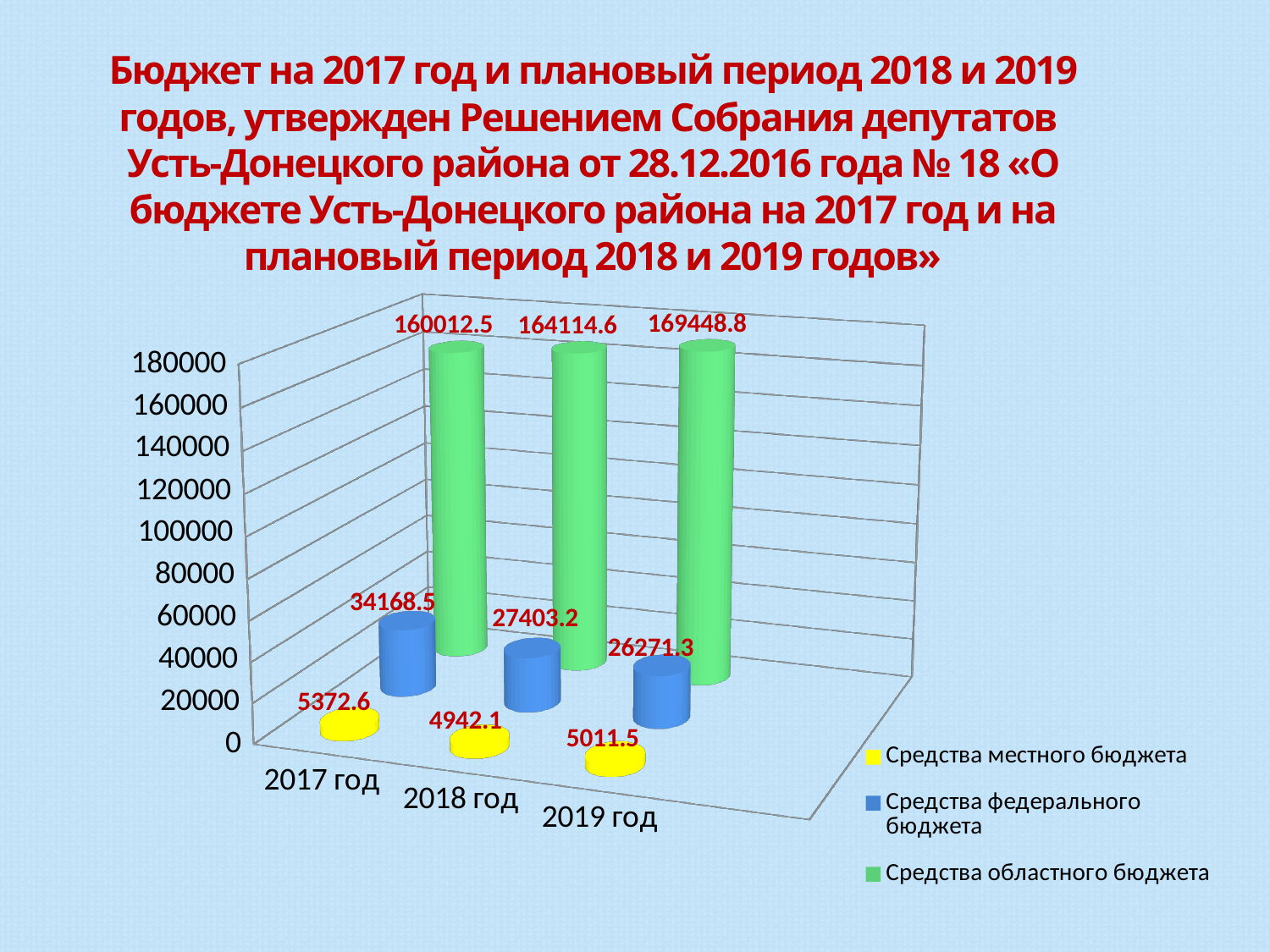
What is the difference between Средства федерального бюджета in 2017 год and in 2019 год? 7897.2 In which year is Средства областного бюджета highest? 2019 год Which is larger: Средства федерального бюджета in 2017 год or in 2018 год? 2017 год Do the values for Средства федерального бюджета rise or fall from 2017 год to 2019 год? Fall What is the value for Средства областного бюджета in 2017 год? 160012.5 How many years are shown on the x axis? 3 In which year is Средства местного бюджета lowest? 2018 год What kind of chart is shown on the slide? Bar chart What is the value for Средства федерального бюджета in 2018 год? 27403.2 What is the value for Средства местного бюджета in 2019 год? 5011.5 How many series does the legend list? 3 What is the difference between Средства областного бюджета in 2019 год and in 2017 год? 9436.3